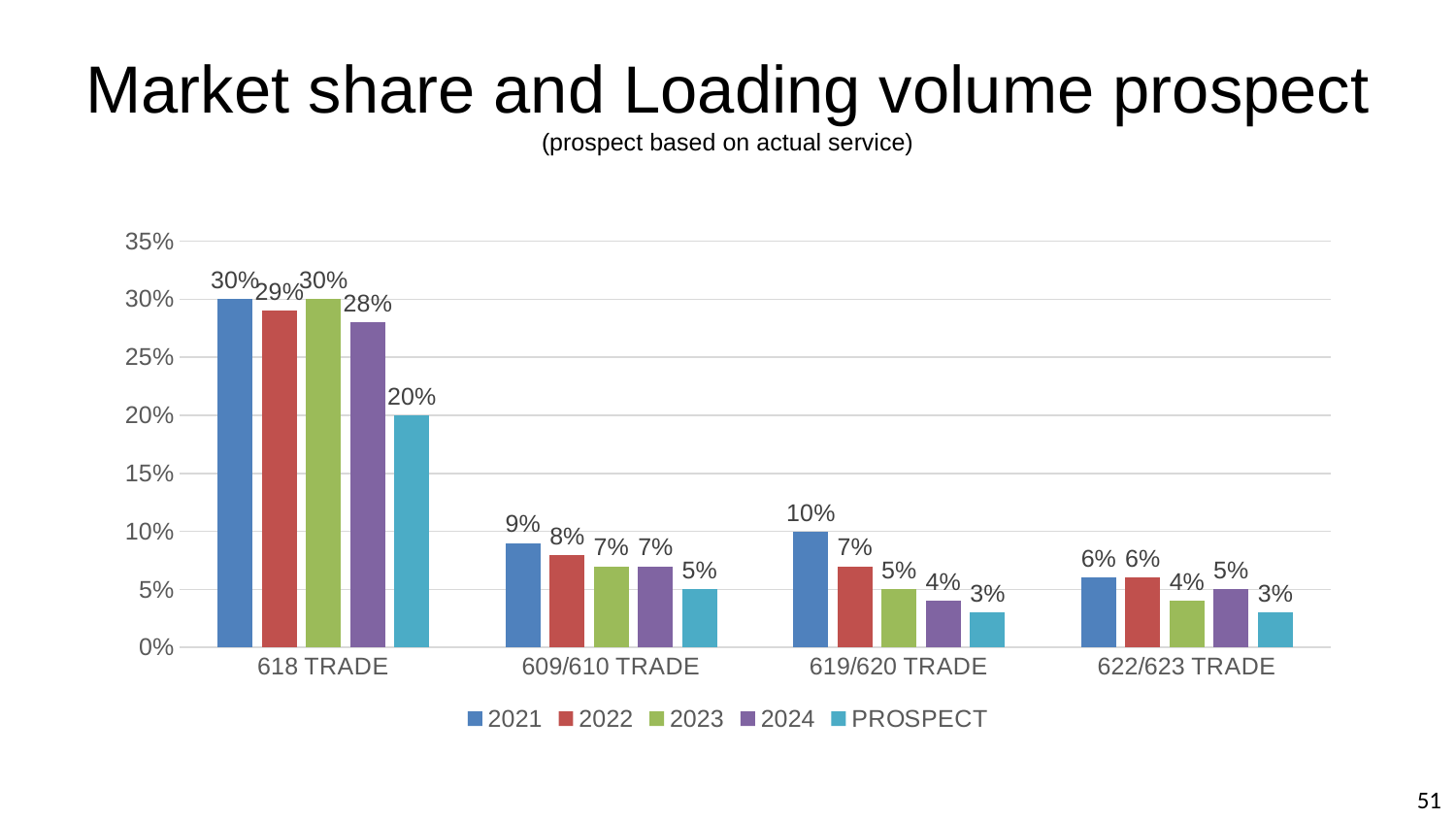
Do the values for 619/620 TRADE rise or fall from 2021 to PROSPECT? Fall What is the PROSPECT value for 609/610 TRADE? 5% What kind of chart is shown on the slide? Bar chart Which is larger for 619/620 TRADE, the 2021 value or the 2022 value? 2021 Which trade has the highest 2021 value? 618 TRADE What is the 2024 value for 619/620 TRADE? 4% What is the 2023 value for 622/623 TRADE? 4% Which series has the lowest value for 618 TRADE? PROSPECT What is the 2021 value for 618 TRADE? 30% What is the difference between the 2024 and PROSPECT values for 618 TRADE? 8% How many trade categories are shown on the x axis? 4 How many series does the legend list? 5